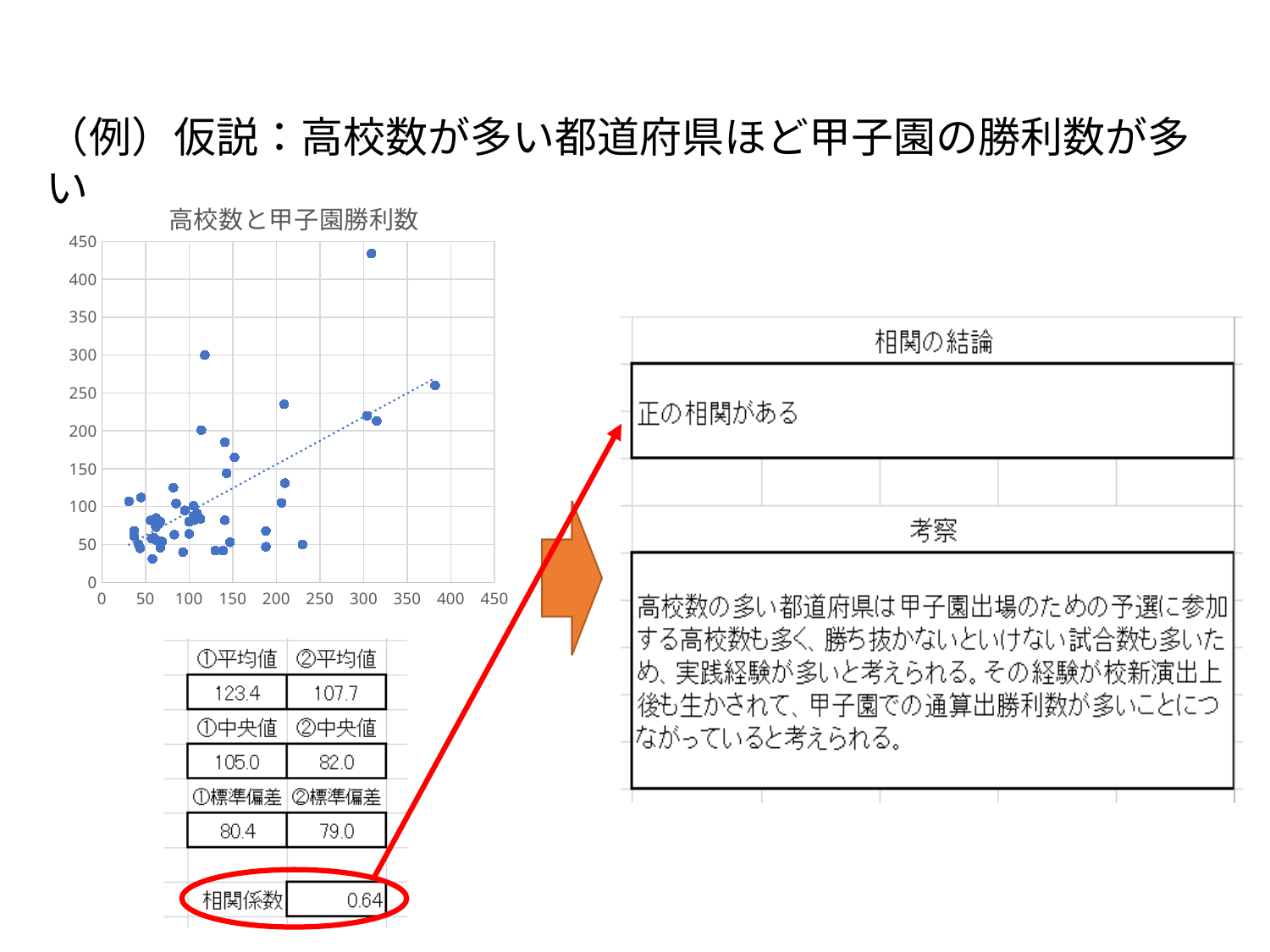
Is the y value of the highest point in the chart greater or less than 400? greater Is the x value of the highest point in the chart greater or less than 250? greater What is the title of the chart? 高校数と甲子園勝利数 Is the y value of the point at about x=120 that lies well above the others greater or less than 250? greater What is the maximum value shown on the y axis of the chart? 450 What kind of chart is shown on the slide? scatter chart Does the dotted trend line in the chart rise or fall as the x-axis value increases? rise Does the chart include a trend line? Yes, a dotted trend line What is the maximum value shown on the x axis of the chart? 450